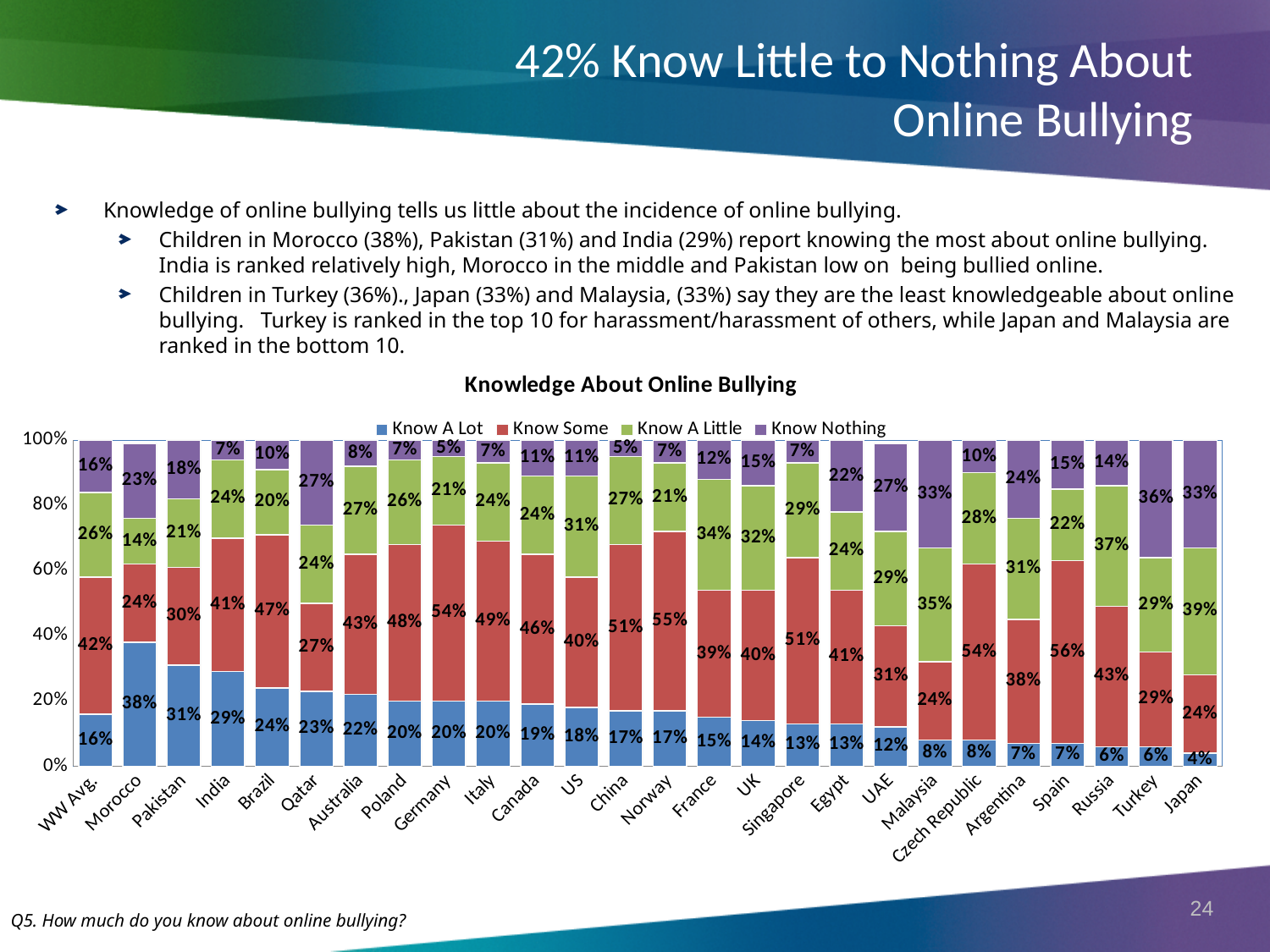
What is the 'Know A Lot' value for Morocco? 38% Which country has the highest 'Know A Lot' value? Morocco What is the title of the chart? Knowledge About Online Bullying Which country has the lowest 'Know A Lot' value? Japan How many series does the legend of the chart list? 4 How many countries/categories are shown along the x axis of the chart? 26 What is the difference between the 'Know A Lot' values for Morocco and Japan? 34 percentage points What is the 'Know A Little' value for Japan? 39% What is the 'Know Nothing' value for Turkey? 36% What kind of chart is shown on the slide? Stacked bar chart Which is larger, the 'Know Nothing' value for Malaysia or for Egypt? Malaysia What is the 'Know Some' value for the WW Avg? 42%